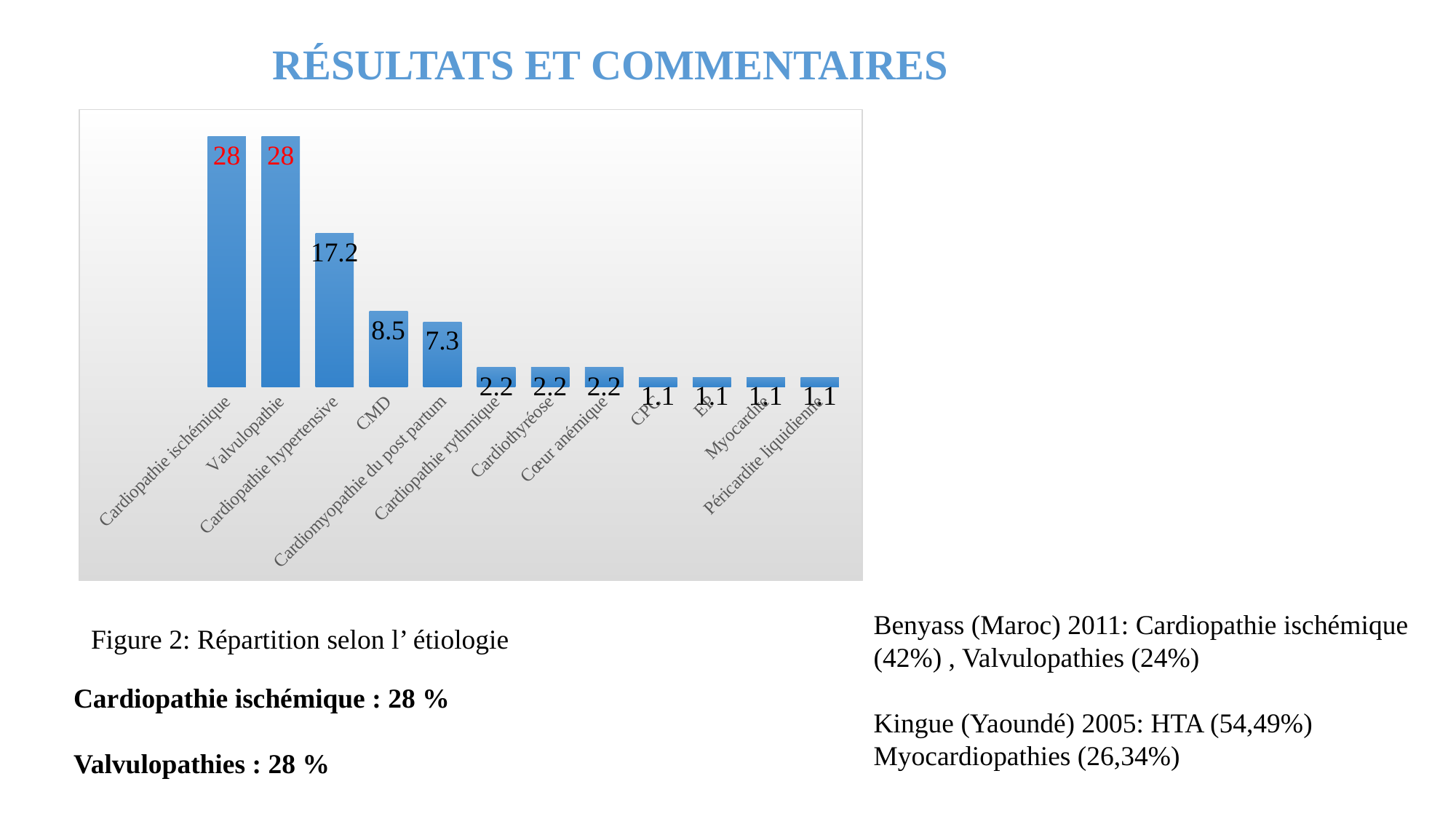
What is the value for Cœur anémique? 2.2 What is the value for Cardiopathie hypertensive? 17.2 What is the difference between the values for CMD and Cardiomyopathie du post partum? 1.2 Which is larger, the value for CMD or the value for Cardiothyréose? CMD Do the values rise or fall from left to right along the x axis? Fall What is the value for Cardiopathie ischémique? 28 How many categories are shown in the chart? 12 What is the value for Cardiomyopathie du post partum? 7.3 What kind of chart is shown on the slide? Bar chart What is the difference between the values for Valvulopathie and Cardiopathie hypertensive? 10.8 What is the value for CMD? 8.5 What is the value for Péricardite liquidienne? 1.1